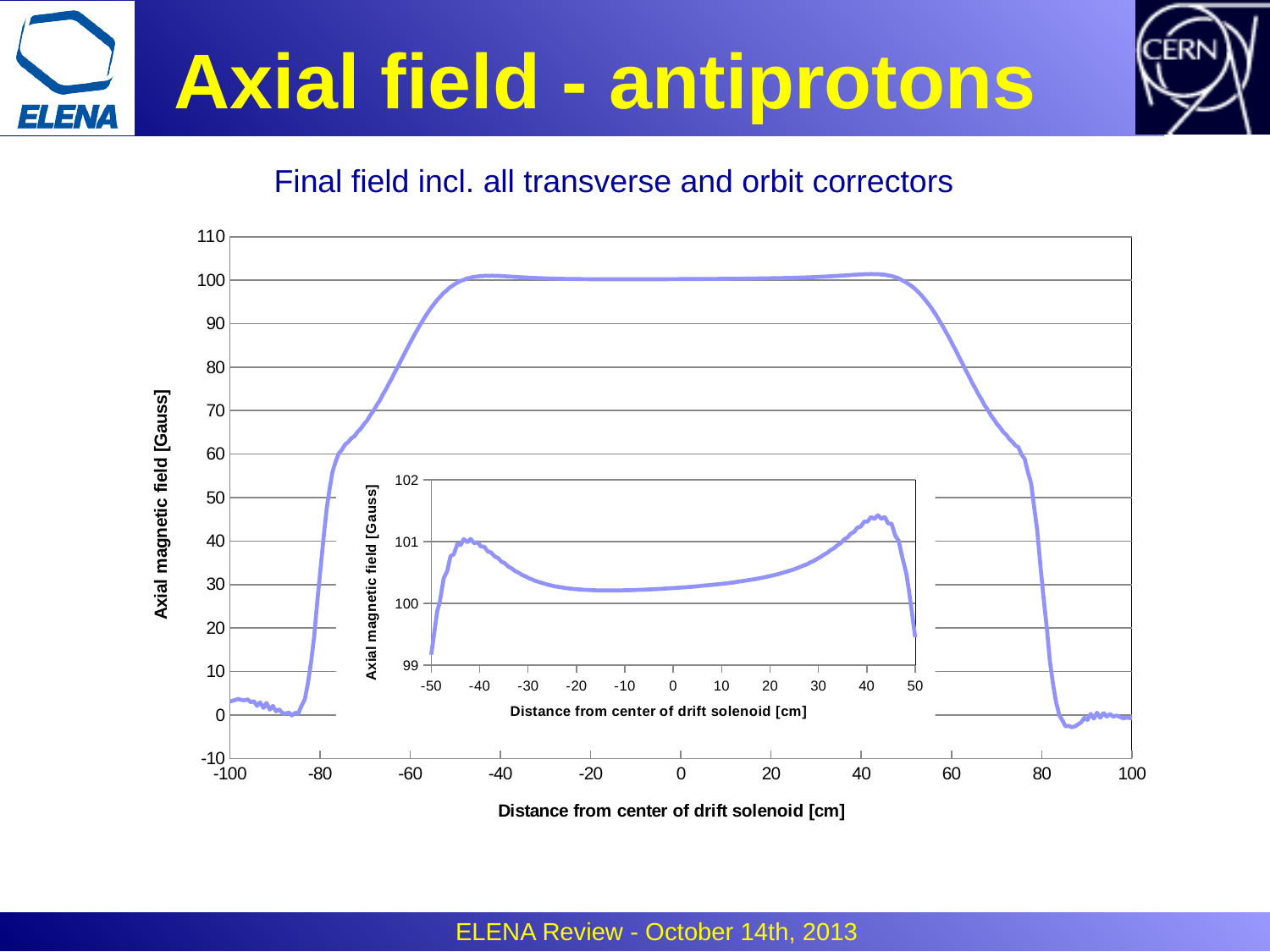
In the main chart, is the axial magnetic field at a distance of -90 cm greater or less than 10 Gauss? less What kind of chart is the inset chart in the lower middle of the slide? line chart What is the title of the vertical axis of the main chart? Axial magnetic field [Gauss] In the inset chart, is the axial magnetic field at a distance of 0 cm greater or less than 101 Gauss? less What kind of chart is the main (large) chart on the slide? line chart In the main chart, is the axial magnetic field at a distance of 90 cm greater or less than 10 Gauss? less In the main chart, does the axial magnetic field rise or fall as the distance goes from 60 cm to 80 cm? fall In the inset chart, does the axial magnetic field rise or fall as the distance goes from 0 cm to 40 cm? rise In the main chart, which is larger: the axial magnetic field at 0 cm or at -90 cm? 0 cm